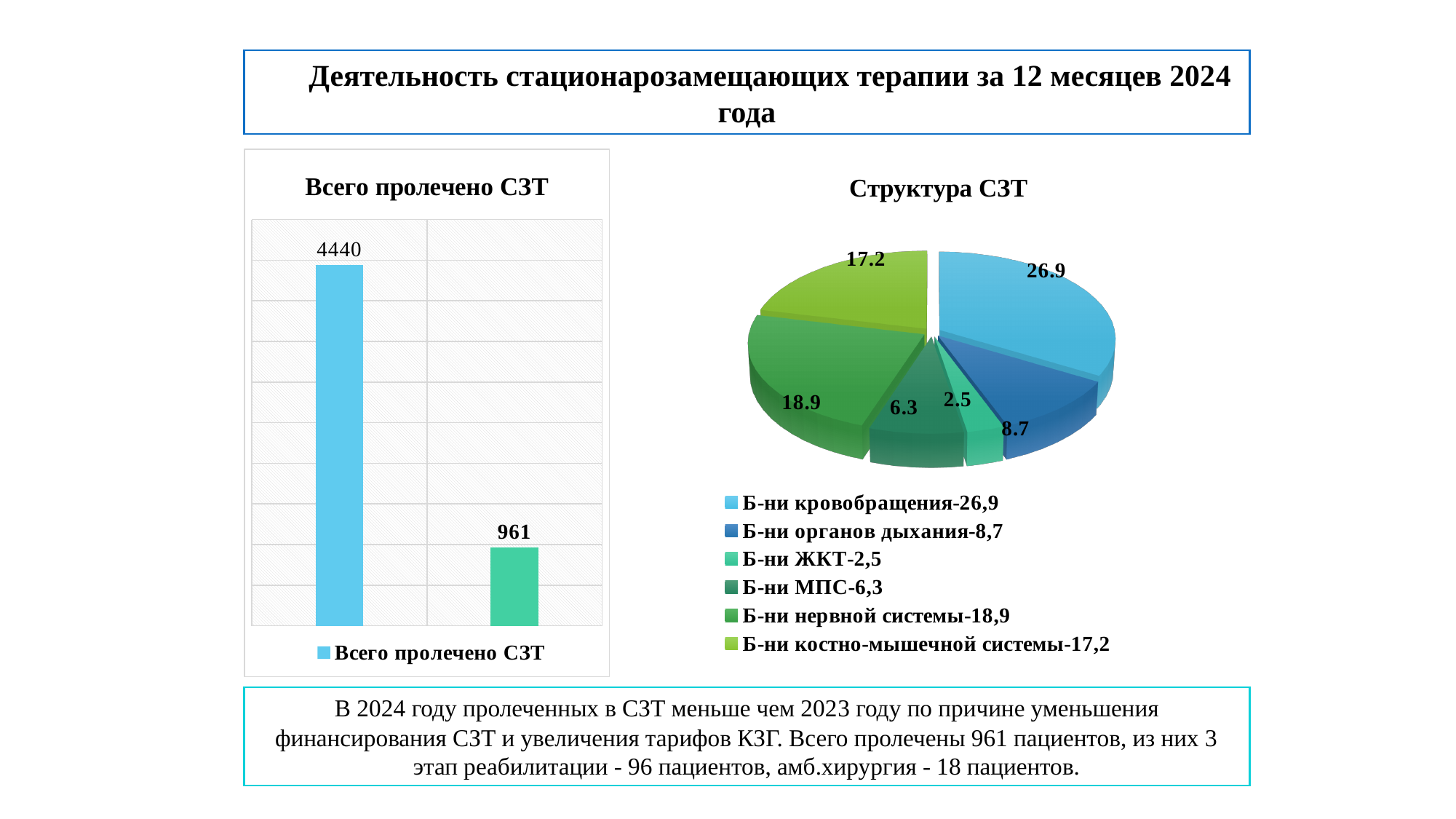
In the 'Структура СЗТ' pie chart, what is the value for 'Б-ни органов дыхания'? 8.7 What type of chart is the 'Всего пролечено СЗТ' chart on the left? bar chart How many categories does the legend of the 'Структура СЗТ' pie chart list? 6 In the 'Структура СЗТ' pie chart, which category has the smallest slice? Б-ни ЖКТ In the 'Всего пролечено СЗТ' chart, what is the value of the left (blue) bar? 4440 In the 'Структура СЗТ' pie chart, which category has the largest slice? Б-ни кровобращения In the 'Структура СЗТ' pie chart, what is the value for 'Б-ни нервной системы'? 18.9 In the 'Всего пролечено СЗТ' chart, what is the difference between the two bars? 3479 How many bars are plotted in the 'Всего пролечено СЗТ' chart? 2 What type of chart is the 'Структура СЗТ' chart on the right? pie chart In the 'Структура СЗТ' pie chart, which is larger: 'Б-ни МПС' or 'Б-ни органов дыхания'? Б-ни органов дыхания In the 'Всего пролечено СЗТ' chart, what is the value of the right (green) bar? 961